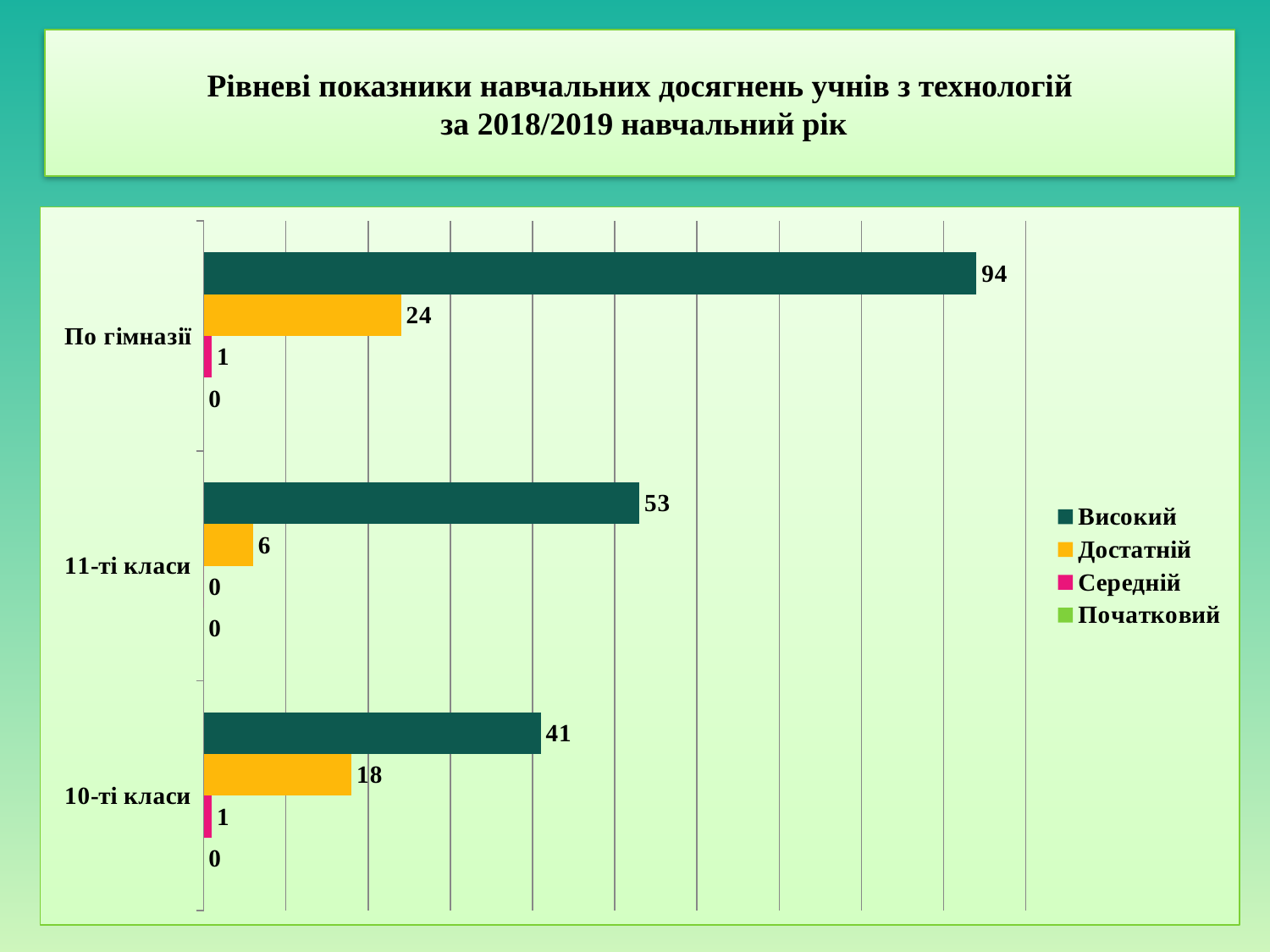
Which series is shown in orange in the legend? Достатній Which category has the highest value for Високий? По гімназії What is the value of Достатній for 11-ті класи? 6 What is the difference between the Високий values for 11-ті класи and 10-ті класи? 12 What is the value of Середній for 11-ті класи? 0 Which is larger: Достатній for 10-ті класи or Достатній for 11-ті класи? 10-ті класи How many categories are shown on the chart? 3 What is the value of Достатній for 10-ті класи? 18 Which category has the lowest value for Достатній? 11-ті класи What is the value of Високий for По гімназії? 94 How many series does the legend list? 4 What kind of chart is shown on the slide? bar chart